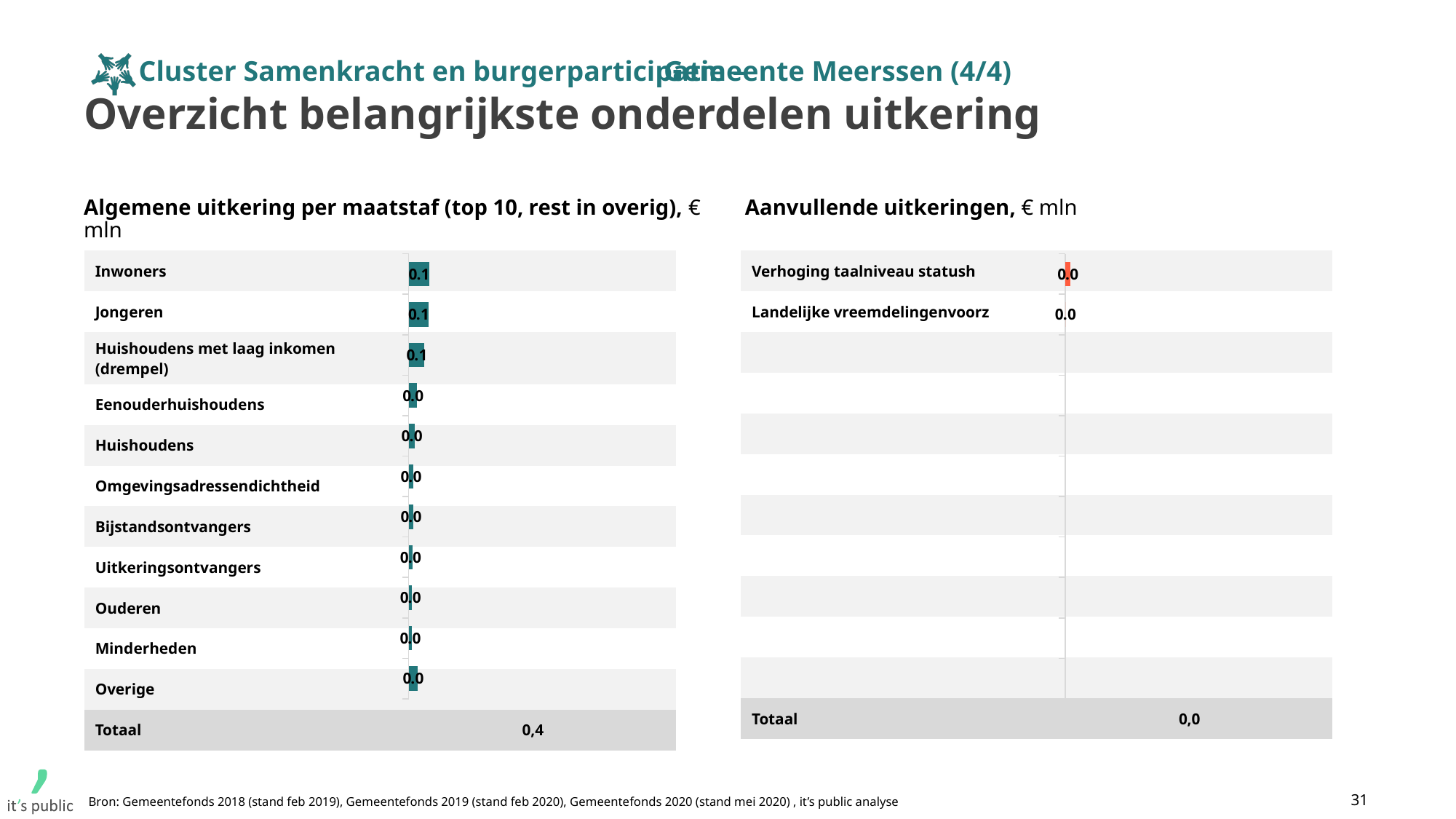
In the left chart 'Algemene uitkering per maatstaf', how many categories (excluding Totaal) are listed? 11 In the right chart 'Aanvullende uitkeringen', what is the value shown for Totaal? 0,0 What kind of chart is the left chart 'Algemene uitkering per maatstaf'? bar chart In the right chart 'Aanvullende uitkeringen', what is the value for Verhoging taalniveau statush? 0.0 In the left chart 'Algemene uitkering per maatstaf', which is larger, the value for Inwoners or the value for Minderheden? Inwoners In the right chart 'Aanvullende uitkeringen', how many categories (excluding Totaal) are listed? 2 In the left chart 'Algemene uitkering per maatstaf', what is the value for Huishoudens met laag inkomen (drempel)? 0.1 In the left chart 'Algemene uitkering per maatstaf', what is the value shown for Totaal? 0,4 In the left chart 'Algemene uitkering per maatstaf', what is the value for Ouderen? 0.0 In the left chart 'Algemene uitkering per maatstaf', do the values rise or fall going down the list from Inwoners to Minderheden? fall In the left chart 'Algemene uitkering per maatstaf', what is the value for Inwoners? 0.1 In the left chart 'Algemene uitkering per maatstaf', what is the value for Jongeren? 0.1